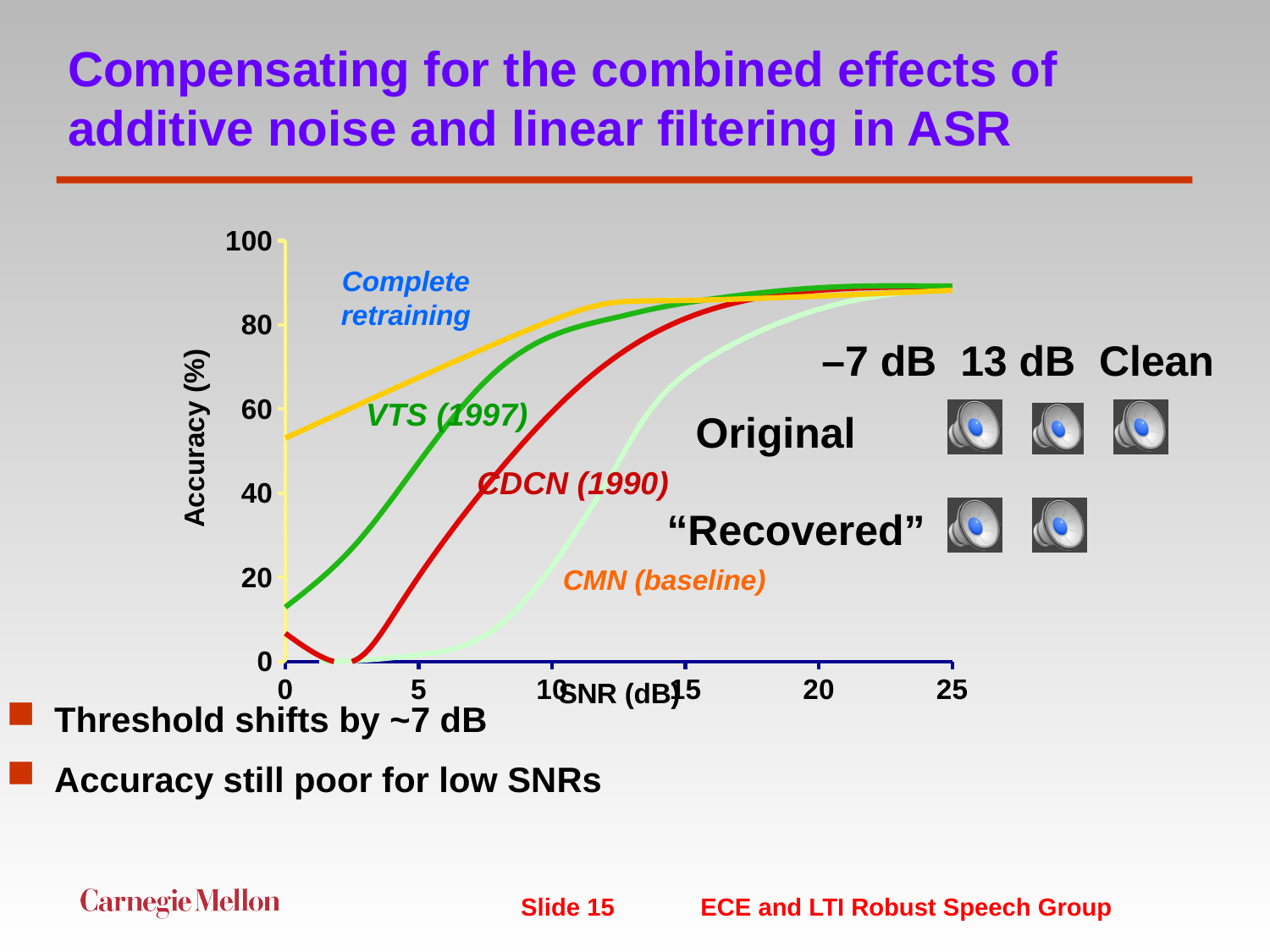
Is the accuracy of the VTS (1997) curve at 0 dB SNR greater or less than 20? less Is the accuracy of the CDCN (1990) curve at 25 dB SNR greater or less than 80? greater Does accuracy rise or fall as SNR increases along the x axis for the CDCN (1990) curve? rise Is the accuracy of the CMN (baseline) curve at 5 dB SNR greater or less than 20? less At 10 dB SNR, which curve has higher accuracy: VTS (1997) or CDCN (1990)? VTS (1997) What is the label of the x axis of the chart? SNR (dB) What is the label of the y axis of the chart? Accuracy (%) Which curve has the highest accuracy at 0 dB SNR? Complete retraining How many labeled curves are plotted on the chart? 4 What kind of chart is shown on the slide? line chart At 5 dB SNR, which curve has higher accuracy: Complete retraining or CMN (baseline)? Complete retraining